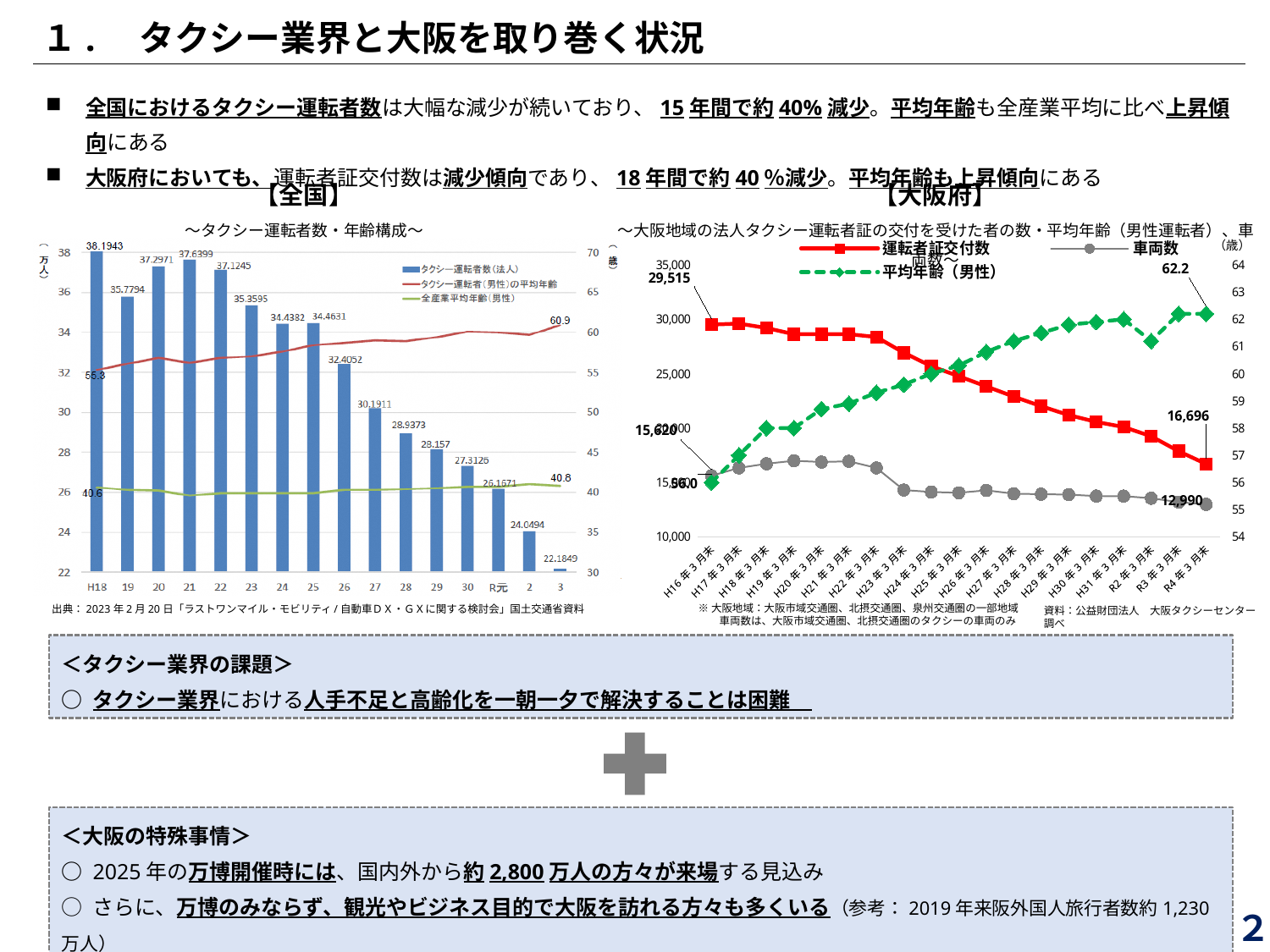
In the left chart (【全国】), what is the value of the bar for 3 (令和3)? 22.1849 In the left chart (【全国】), how many bars (years) are plotted? 16 In the left chart (【全国】), which year has the lowest bar? 3 In the right chart (【大阪府】), what is the value of 運転者証交付数 at R4年3月末? 16,696 In the right chart (【大阪府】), what is the value of 運転者証交付数 at H16年3月末? 29,515 In the right chart (【大阪府】), what is the value of 車両数 at R4年3月末? 12,990 In the left chart (【全国】), what is the last labelled value of the タクシー運転者(男性)の平均年齢 line? 60.9 In the right chart (【大阪府】), how many series does the legend list? 3 In the left chart (【全国】), what is the value of the bar for H18? 38.1943 In the left chart (【全国】), does the bar series rise or fall from H18 to 3 overall? fall In the left chart (【全国】), what is the difference between the bar values for H18 and 3? 15.0094 In the left chart (【全国】), which year has the highest bar? H18